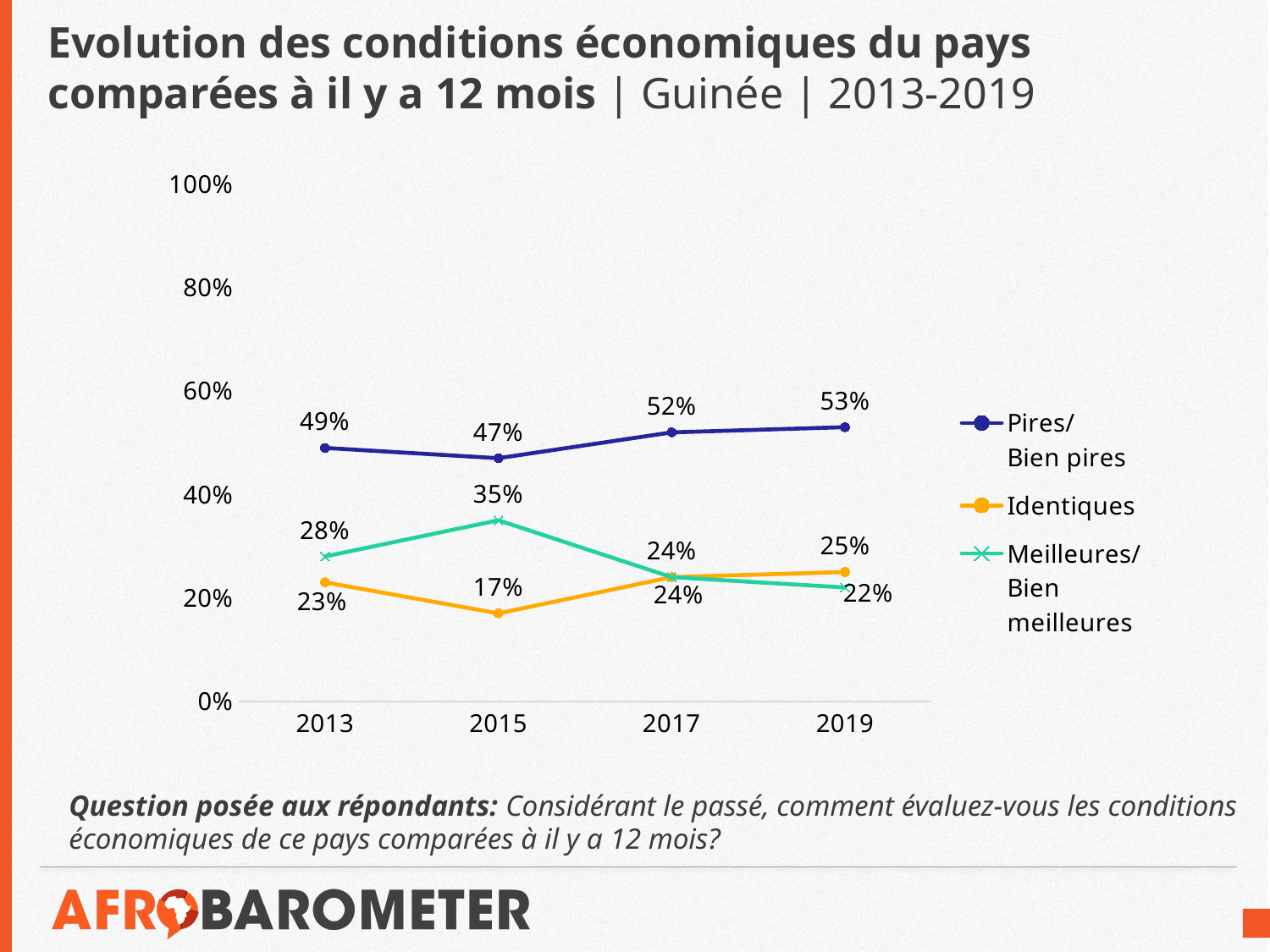
Does the Meilleures/Bien meilleures series rise or fall from 2015 to 2019? fall What is the value for Meilleures/Bien meilleures in 2015? 35% What is the value for Pires/Bien pires in 2019? 53% How many years are plotted along the x axis? 4 What is the difference between Pires/Bien pires and Identiques in 2019? 28 percentage points What type of chart is shown on the slide? line chart Which country does the chart title say the data is for? Guinée Which is larger in 2013: Identiques or Meilleures/Bien meilleures? Meilleures/Bien meilleures In which year is the Pires/Bien pires series at its lowest? 2015 In which year is the Meilleures/Bien meilleures series at its highest? 2015 How many series does the legend list? 3 What is the value for Identiques in 2015? 17%